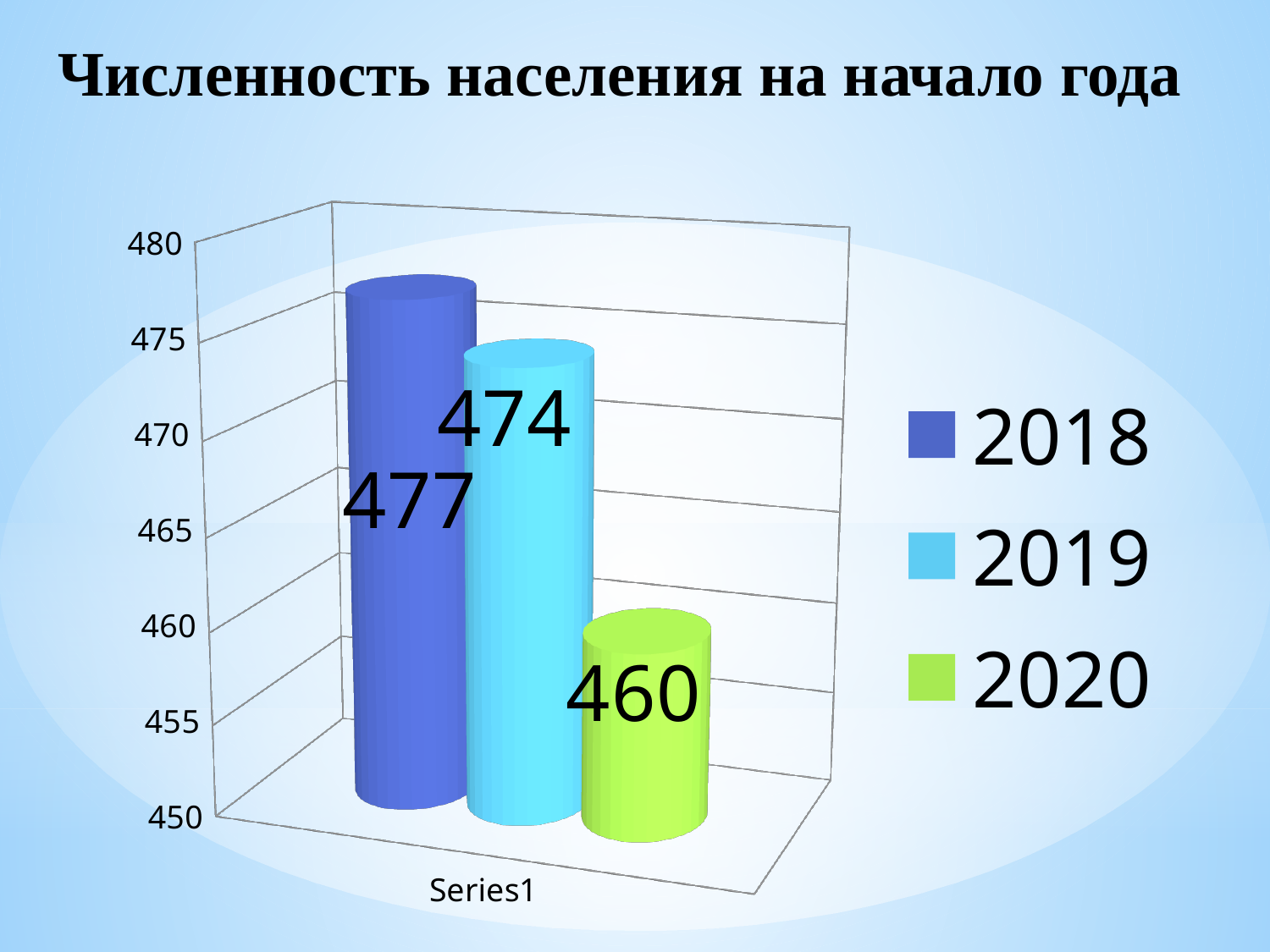
Which year has the highest value? 2018 Is the value for 2020 greater or less than 465? less What is the value for 2018? 477 What is the value for 2020? 460 What is the difference between the values for 2018 and 2019? 3 What kind of chart is shown on the slide? bar chart What is the value for 2019? 474 How many series does the legend list? 3 Which year has the lowest value? 2020 Which is larger, the value for 2019 or the value for 2020? 2019 What is the difference between the values for 2018 and 2020? 17 What is the title of the chart? Численность населения на начало года